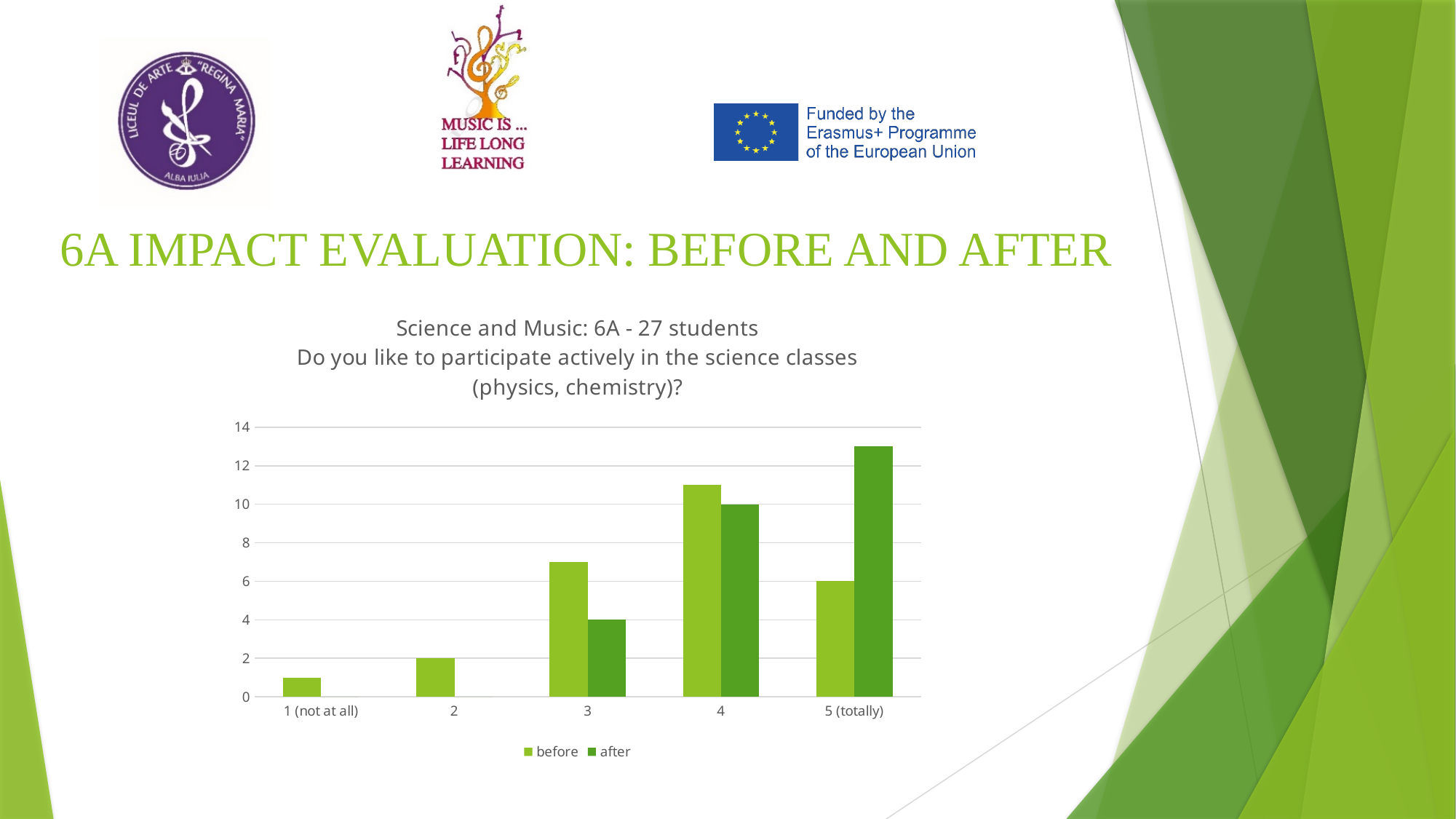
Which category has the highest 'before' value? 4 What is the 'before' value for category 2? 2 For '5 (totally)', which is larger, the 'before' or the 'after' value? after What is the 'before' value for '5 (totally)'? 6 Is the 'after' value for '5 (totally)' greater or less than 12? greater Which category has the highest 'after' value? 5 (totally) What kind of chart is shown on the slide? bar chart What is the 'after' value for category 3? 4 How many series does the legend list? 2 What is the 'after' value for category 4? 10 How many categories are shown on the x axis? 5 What is the difference between the 'after' values for category 4 and category 3? 6